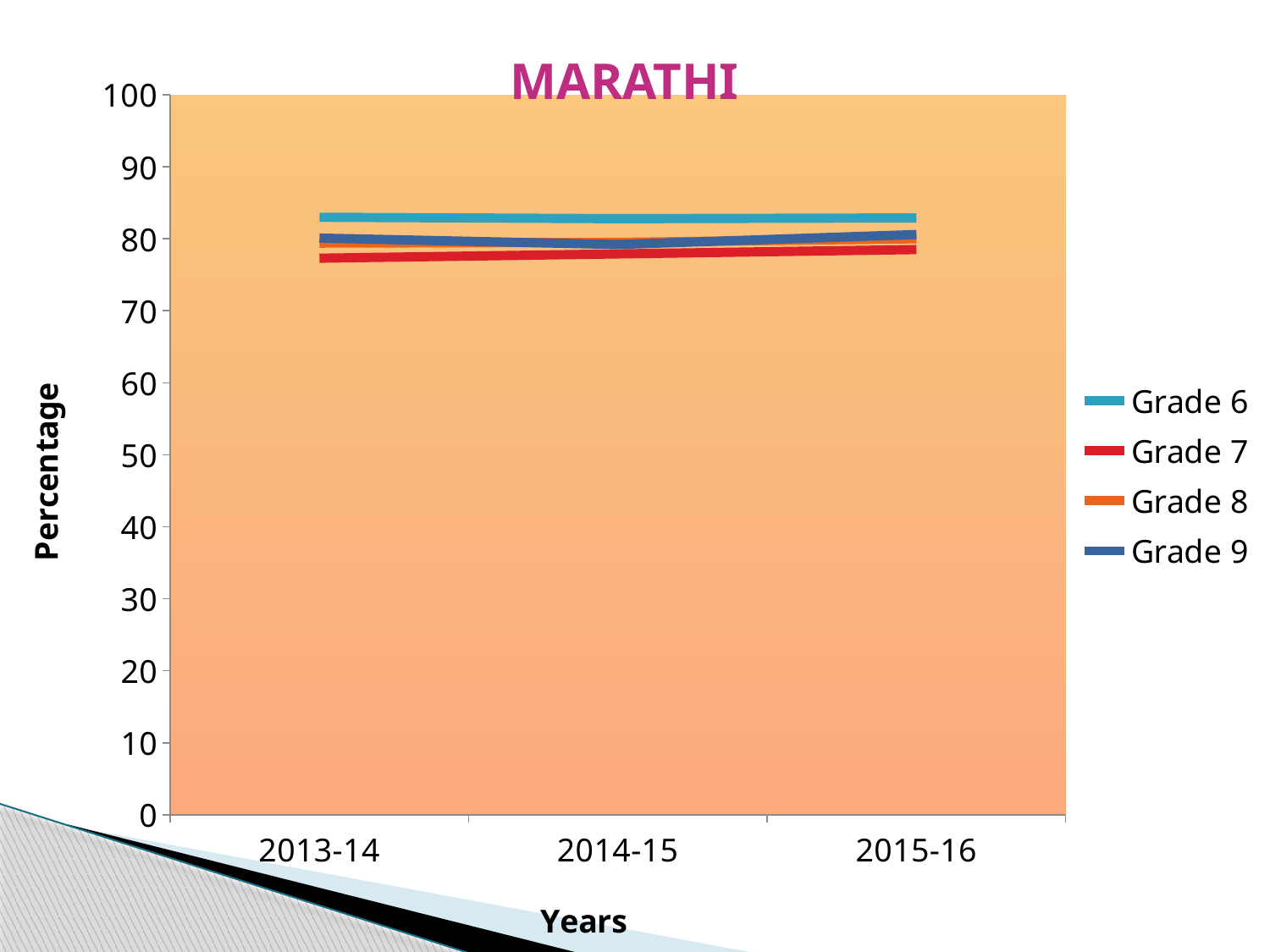
Which is larger in 2015-16, the value for Grade 6 or the value for Grade 7? Grade 6 What is the label of the vertical axis? Percentage Does the Grade 7 line rise or fall from 2013-14 to 2015-16? rise What kind of chart is shown on the slide? line chart Is the value for Grade 7 in 2013-14 greater or less than 80? less Which grade has the highest percentage across all years? Grade 6 How many years are shown on the x axis? 3 Is the value for Grade 6 in 2014-15 greater or less than 80? greater Which grade has the lowest percentage in 2013-14? Grade 7 Is the value for Grade 9 in 2015-16 greater or less than 70? greater What is the title of the chart? MARATHI How many series does the legend list? 4